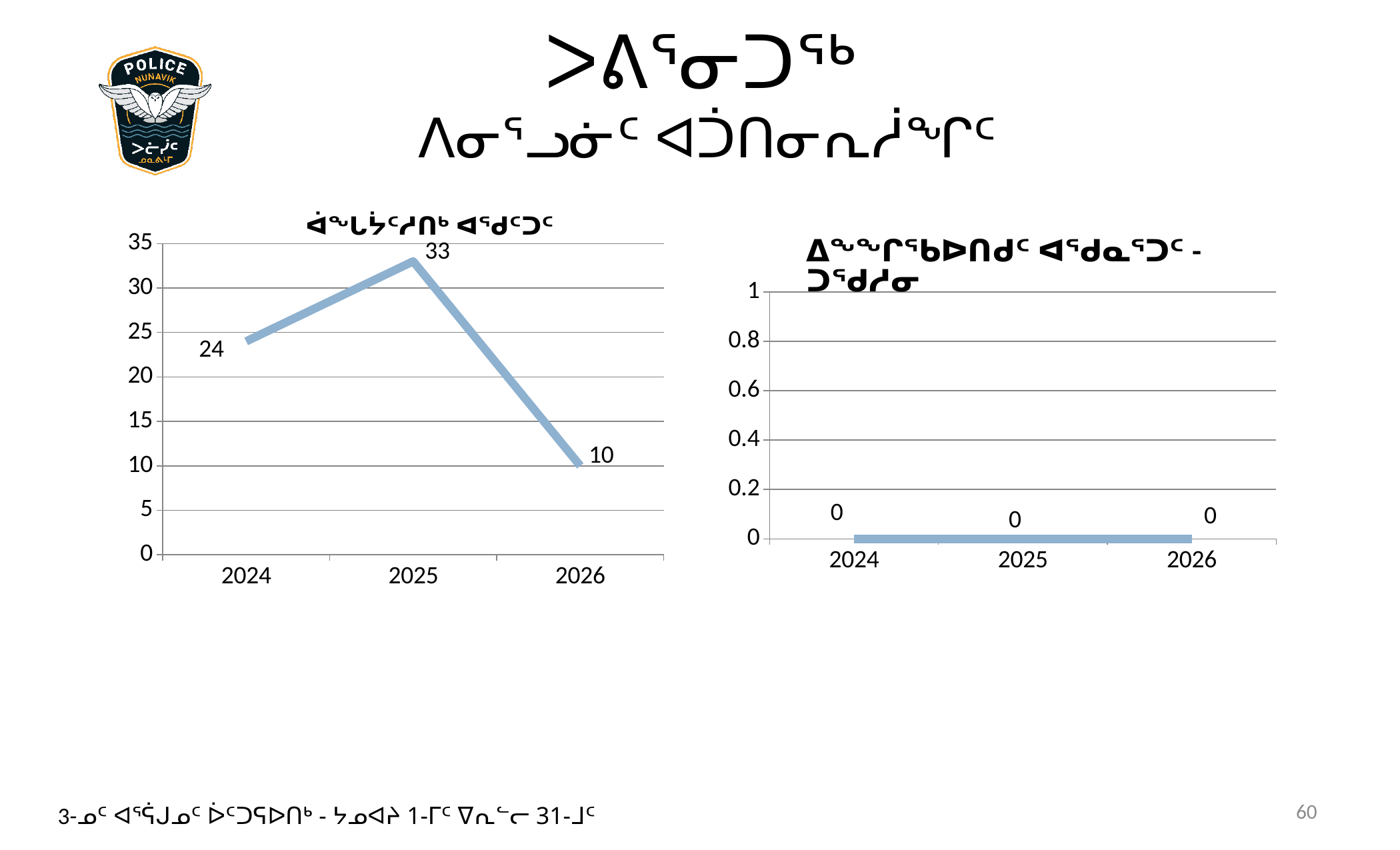
On the left chart, what is the value for 2025? 33 On the left chart, is the value for 2025 greater or less than 30? greater On the left chart, which year has the lowest value? 2026 On the left chart, which year has the highest value? 2025 On the left chart, what is the difference between the values for 2025 and 2026? 23 On the left chart, which is larger, the value for 2024 or the value for 2026? 2024 On the left chart, how many years are plotted on the x axis? 3 What kind of chart is the left chart? line chart On the left chart, what is the value for 2024? 24 On the left chart, does the value rise or fall from 2025 to 2026? fall On the right chart, what is the value for 2025? 0 On the left chart, what is the value for 2026? 10